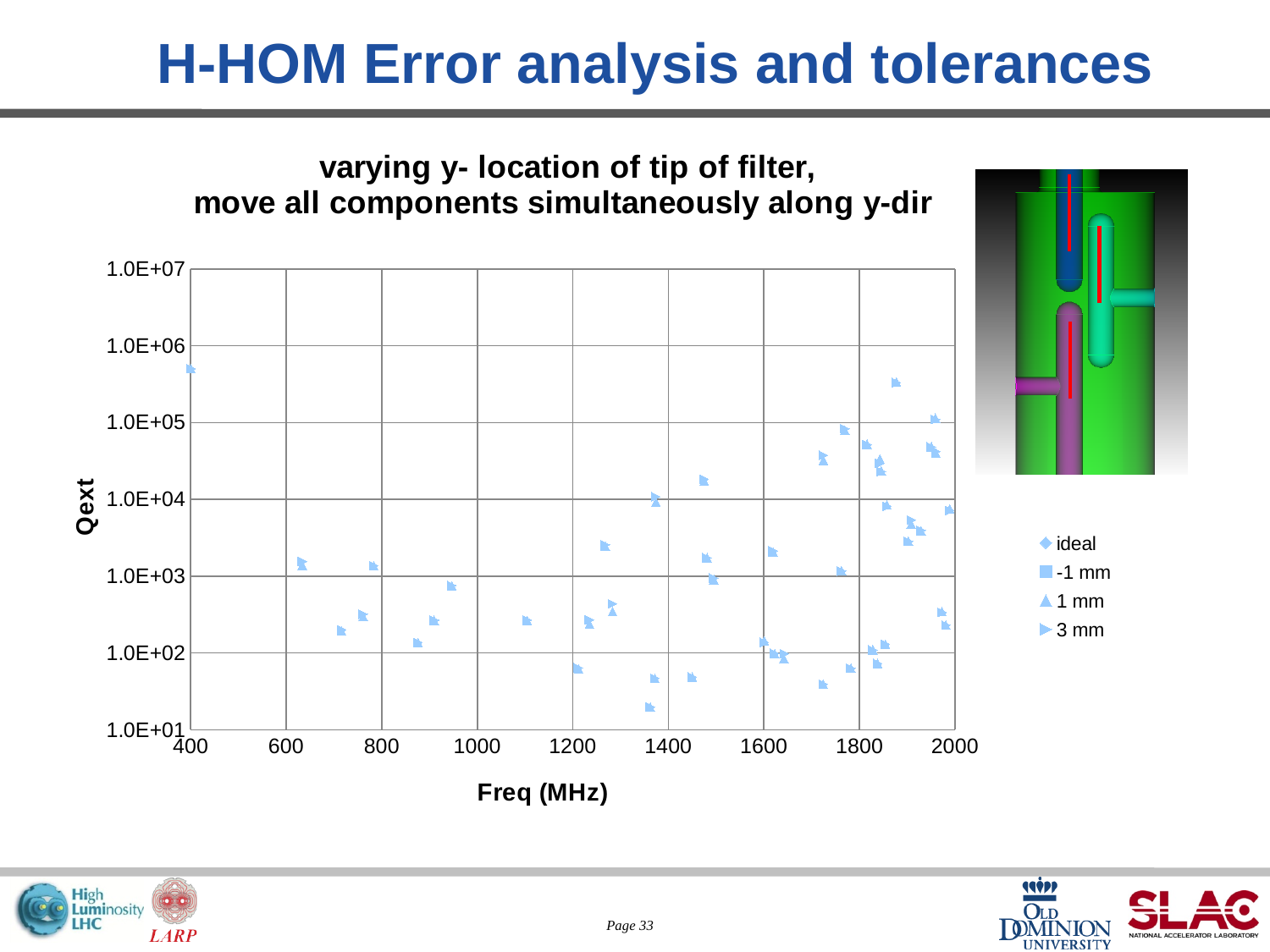
Is the Qext value of the highest point near 1880 MHz greater or less than 1.0E+06? less How many series does the legend list? 4 What are the series names listed in the legend? ideal, -1 mm, 1 mm, 3 mm What is the maximum value shown on the Qext axis? 1.0E+07 Is the Qext value of the point plotted at about 400 MHz greater or less than 1.0E+05? greater What is the label of the x axis? Freq (MHz) What kind of chart is shown on the slide? scatter chart Is the Qext value of the lowest point, near 1370 MHz, greater or less than 1.0E+02? less